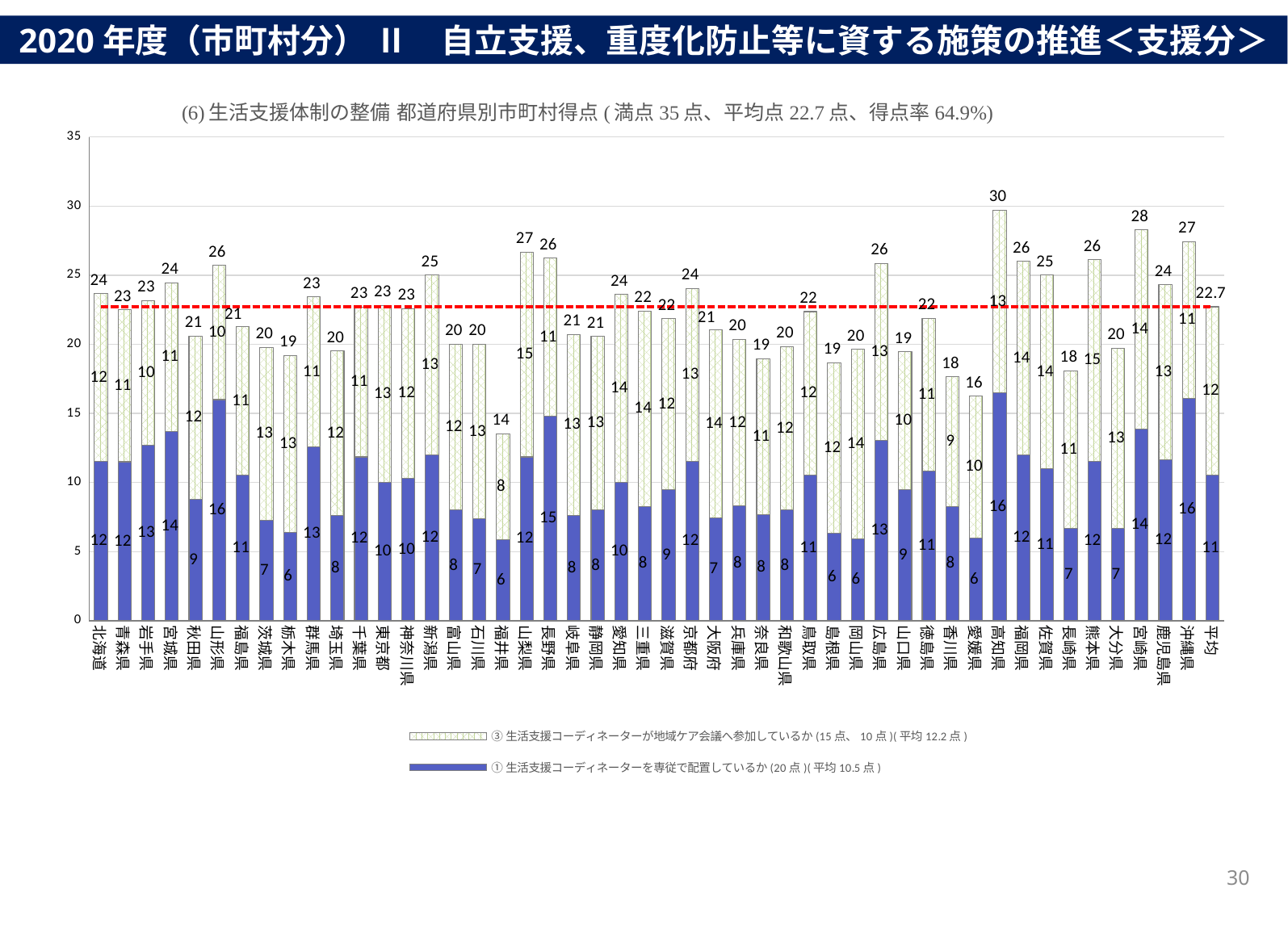
What kind of chart is shown on the slide? stacked bar chart What is the value of the ③ 生活支援コーディネーターが地域ケア会議へ参加しているか series for 山梨県? 15 What is the total of the stacked bar for 広島県? 26 Which prefecture has the lowest total score? 福井県 Is the total score for 愛媛県 greater or less than 20? less What is the value of the ① 生活支援コーディネーターを専従で配置しているか series for 山形県? 16 Which has a higher total score, 沖縄県 or 鹿児島県? 沖縄県 What value does the red dashed horizontal line mark? 22.7 What is the difference between the total scores of 高知県 and 福井県? 16 What is the total score for 宮崎県? 28 Which prefecture has the highest total score? 高知県 How many series does the legend list? 2